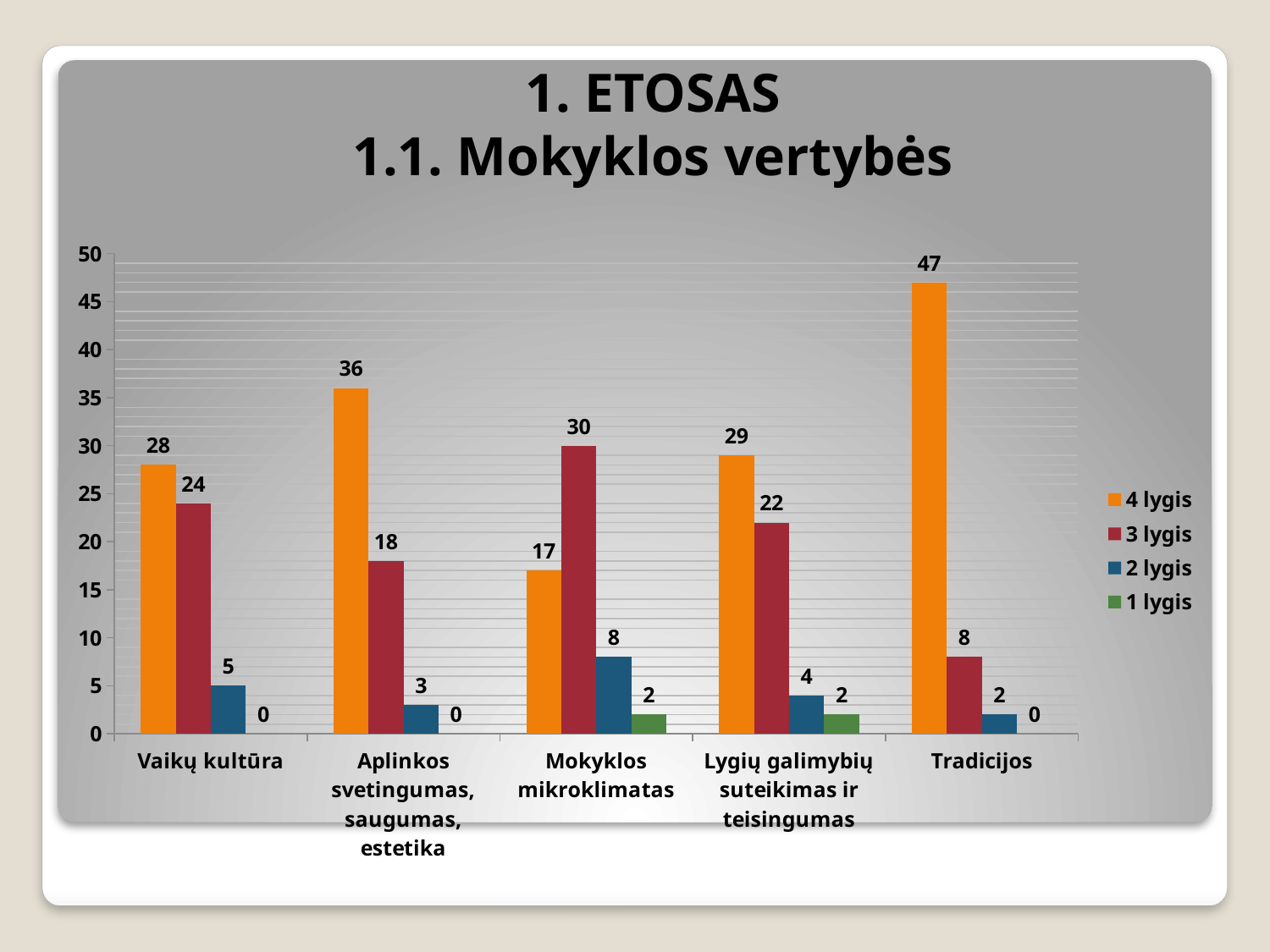
What is the value of the 4 lygis series for Tradicijos? 47 How many series does the legend list? 4 What is the value of the 2 lygis series for Vaikų kultūra? 5 How many categories are shown on the x axis? 5 For Mokyklos mikroklimatas, which is larger: the 4 lygis value or the 3 lygis value? 3 lygis What is the value of the 3 lygis series for Mokyklos mikroklimatas? 30 Which category has the highest value in the 4 lygis series? Tradicijos Which category has the lowest value in the 4 lygis series? Mokyklos mikroklimatas What is the value of the 1 lygis series for Lygių galimybių suteikimas ir teisingumas? 2 What is the difference between the 4 lygis and 3 lygis values for Aplinkos svetingumas, saugumas, estetika? 18 Which series is shown in orange in the legend? 4 lygis What kind of chart is shown on the slide? Bar chart